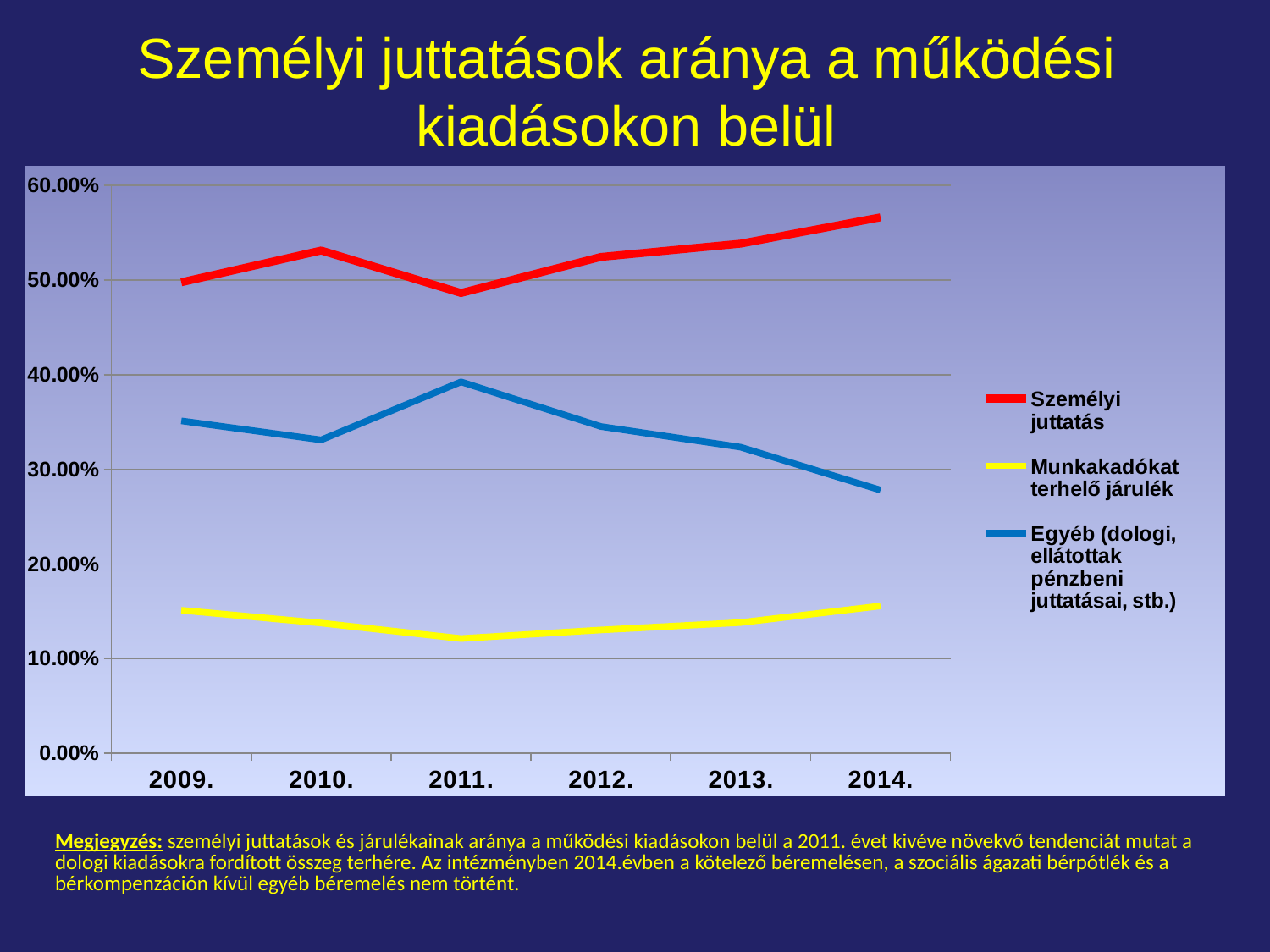
Which series has the larger value in 2014: Személyi juttatás or Egyéb (dologi, ellátottak pénzbeni juttatásai, stb.)? Személyi juttatás Is the value for Munkakadókat terhelő járulék in 2011 greater or less than 10.00%? greater Is the value for Egyéb (dologi, ellátottak pénzbeni juttatásai, stb.) in 2009 greater or less than 30.00%? greater Does the Egyéb (dologi, ellátottak pénzbeni juttatásai, stb.) series rise or fall from 2011 to 2014? fall In which year is the Egyéb (dologi, ellátottak pénzbeni juttatásai, stb.) series at its highest? 2011. Is the value for Személyi juttatás in 2014 greater or less than 50.00%? greater How many series does the legend list? 3 In which year is the Személyi juttatás series at its lowest? 2011. What kind of chart is shown on the slide? line chart In which year is the Személyi juttatás series at its highest? 2014. How many years are shown on the x axis? 6